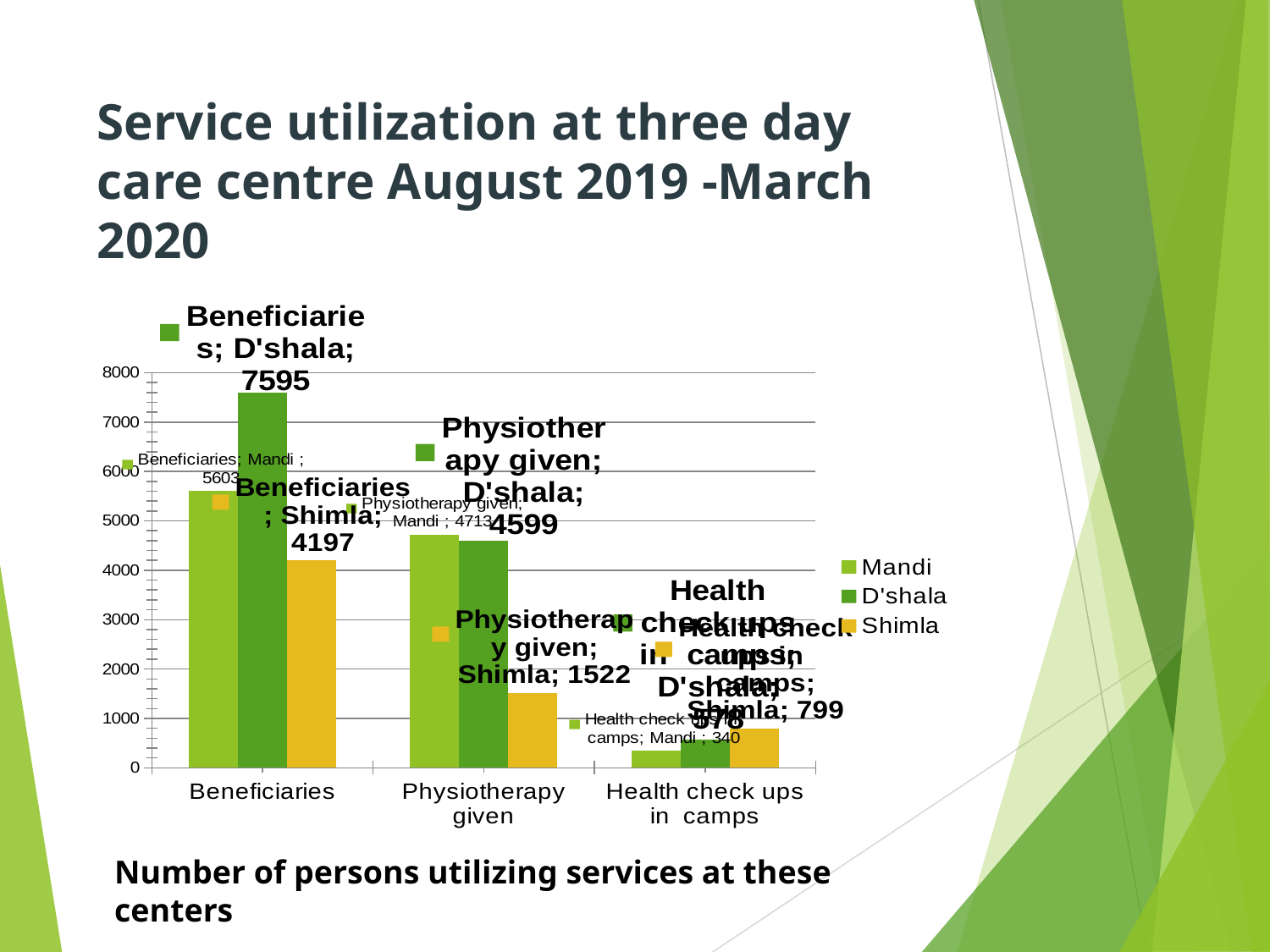
What is the value for D'shala in the Beneficiaries category? 7595 What is the value for Shimla in the Health check ups in camps category? 799 What is the value for Shimla in the Beneficiaries category? 4197 What is the value for Shimla in the Physiotherapy given category? 1522 Is the value for D'shala in the Health check ups in camps category greater or less than 1000? less What is the value for Mandi in the Beneficiaries category? 5603 What is the value for Mandi in the Physiotherapy given category? 4713 What kind of chart is shown on the slide? bar chart Which centre has the highest value in the Beneficiaries category? D'shala In the Physiotherapy given category, which is larger: Mandi or D'shala? Mandi How many series does the legend list? 3 What is the difference between the D'shala and Shimla values in the Beneficiaries category? 3398